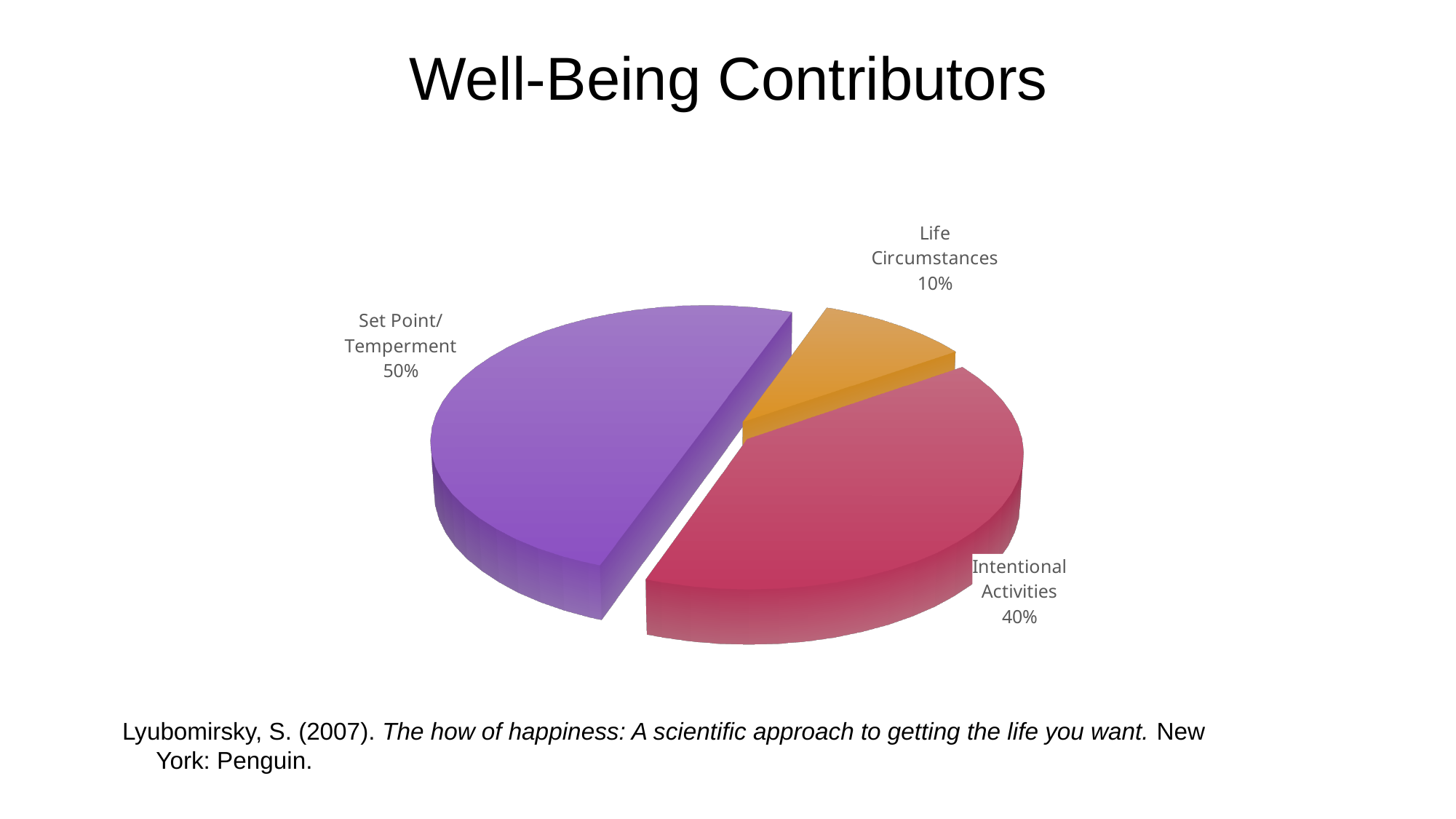
What is the difference in percentage points between Intentional Activities and Life Circumstances? 30% What is the title of the chart on the slide? Well-Being Contributors What is the difference in percentage points between Set Point/Temperment and Intentional Activities? 10% What share of the pie does Life Circumstances account for? 10% What colour is the slice for Life Circumstances? Orange What share of the pie does Intentional Activities account for? 40% Which category has the largest slice of the pie? Set Point/Temperment How many slices does the pie chart have? 3 What share of the pie does Set Point/Temperment account for? 50% What kind of chart is shown on the slide? Pie chart Which is larger, the slice for Intentional Activities or the slice for Life Circumstances? Intentional Activities Which category has the smallest slice of the pie? Life Circumstances